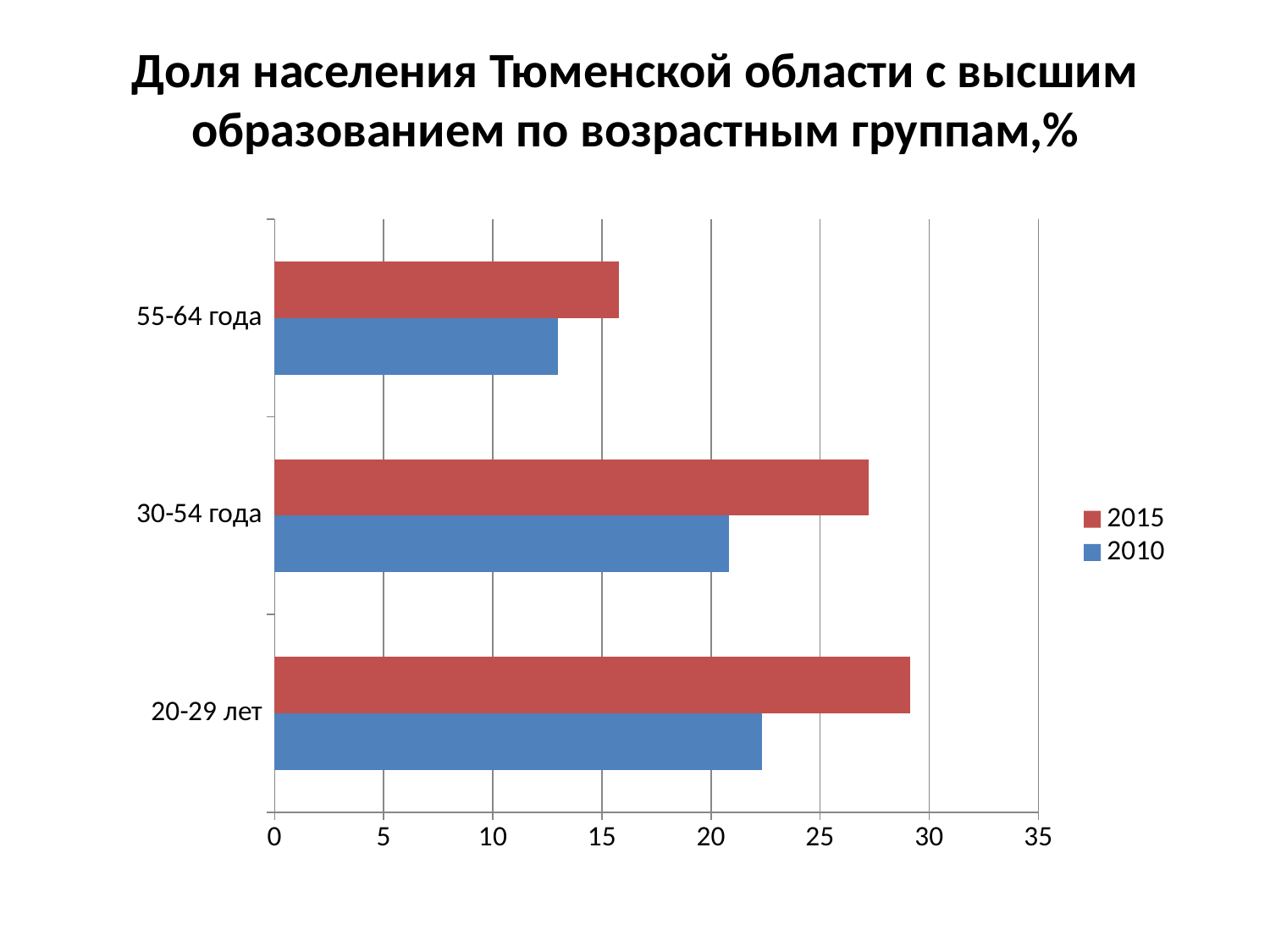
What kind of chart is shown on the slide? bar chart Which series is shown in red in the legend? 2015 Which age group has the lowest value for 2010? 55-64 года Is the 2015 value for 30-54 года greater or less than 25? greater How many age groups are shown on the chart? 3 How many series does the legend list? 2 Is the 2010 value for 55-64 года greater or less than 15? less Is the 2015 value for 55-64 года greater or less than 20? less For the 30-54 года group, which year has the larger value, 2015 or 2010? 2015 Which age group has the highest value for 2015? 20-29 лет Which age group has the lowest value for 2015? 55-64 года